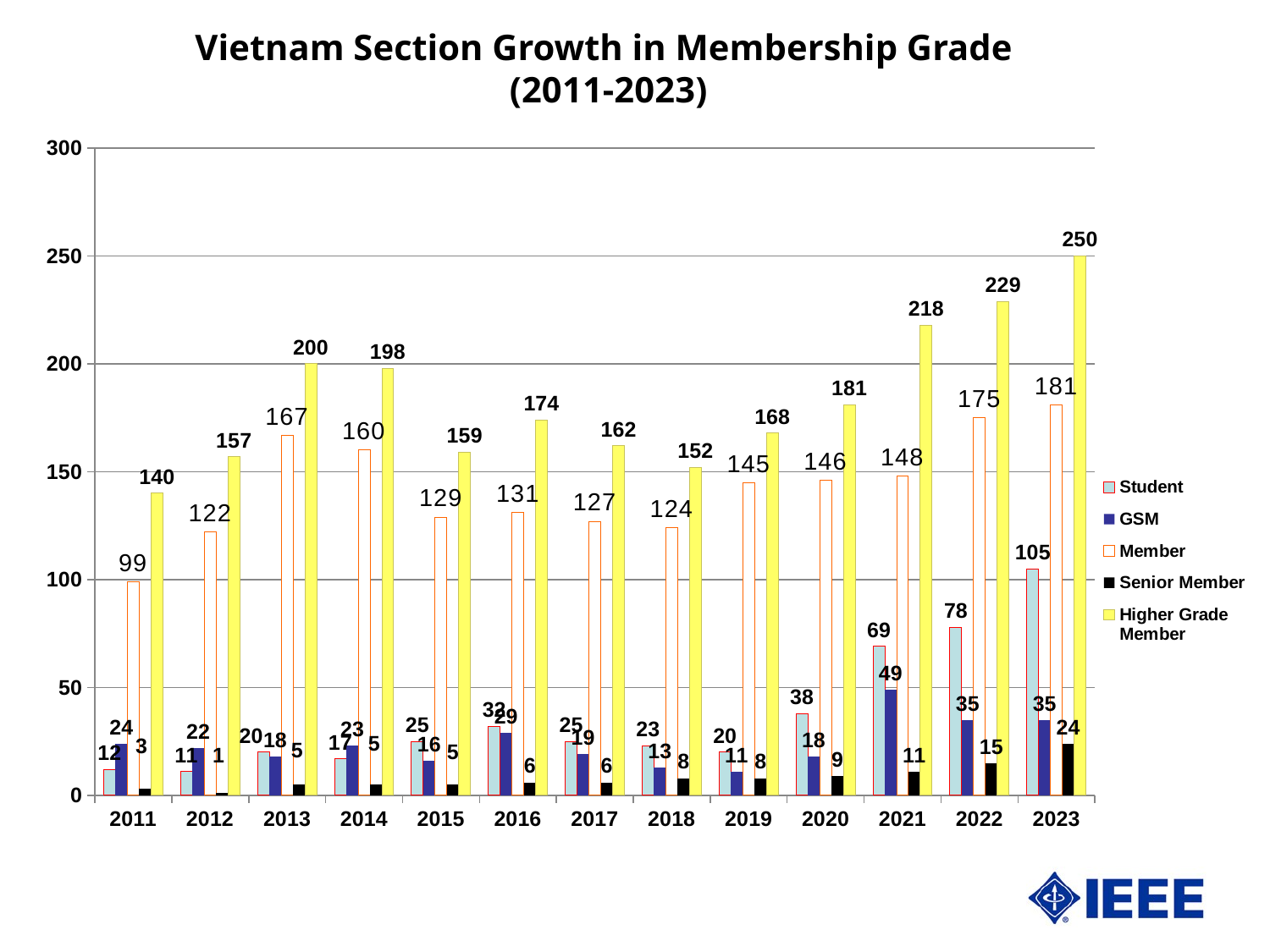
How many years are shown on the x axis? 13 Which year has the lowest Member value? 2011 What is the Higher Grade Member value for 2023? 250 Does the Student value rise or fall from 2019 to 2023? Rise What is the Student value for 2021? 69 Which is larger, the GSM value for 2011 or the GSM value for 2012? 2011 What is the Senior Member value for 2012? 1 How many series does the legend list? 5 What is the difference between the Higher Grade Member values for 2023 and 2022? 21 What kind of chart is shown on the slide? Bar chart What is the Member value for 2014? 160 Which year has the highest Higher Grade Member value? 2023